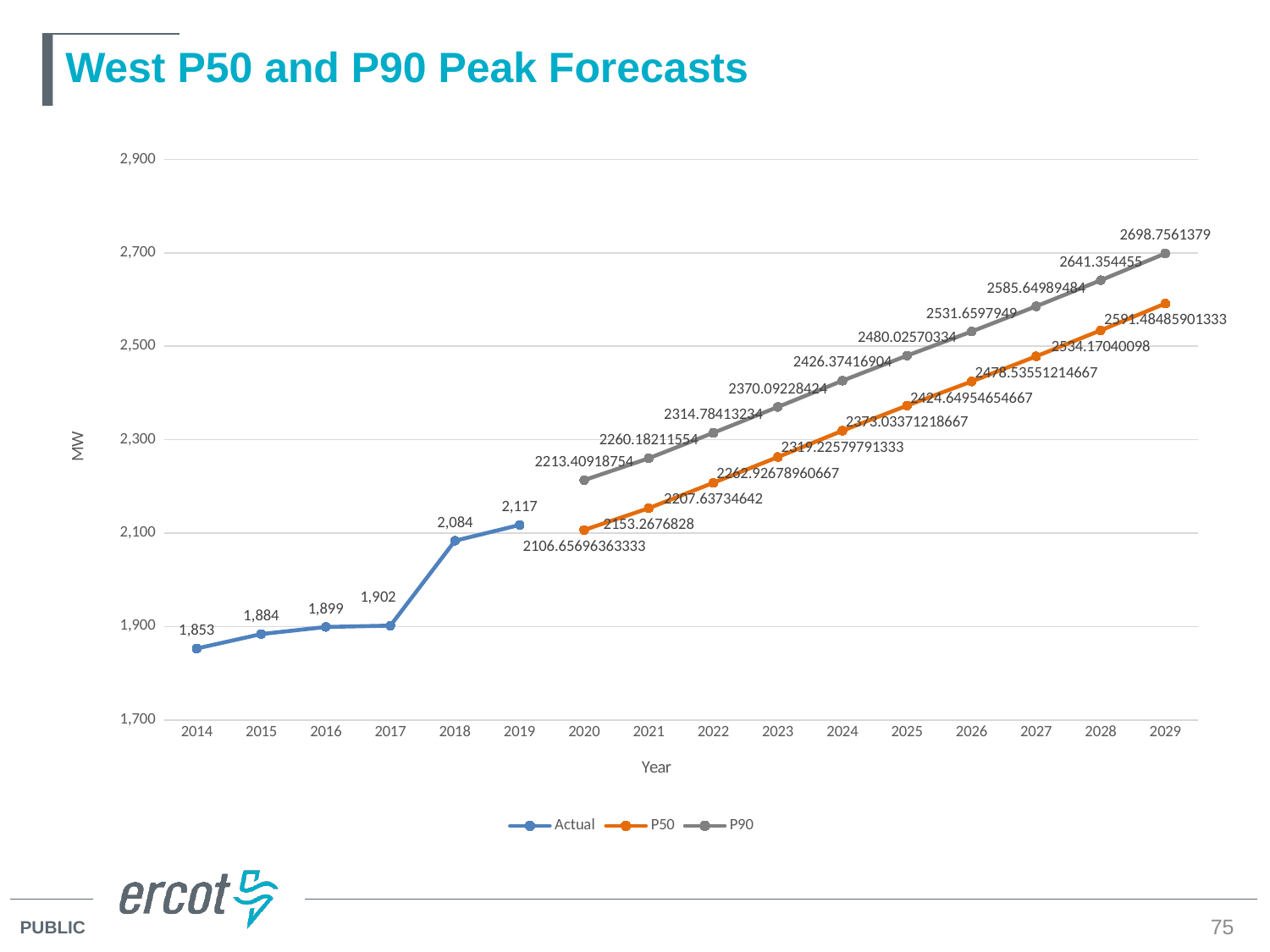
Do the P50 values rise or fall from 2020 to 2029? rise What is the difference between the Actual values for 2019 and 2018? 33 How many series does the legend list? 3 What is the P90 value for 2029? 2698.7561379 Which year has the lowest Actual value? 2014 What is the Actual value for 2014? 1,853 What type of chart is shown on the slide? line chart What is the Actual value for 2019? 2,117 What is the difference between the Actual values for 2018 and 2017? 182 Which series is higher in 2025, P50 or P90? P90 What is the P90 value for 2020? 2213.40918754 What is the P50 value for 2021? 2153.2676828